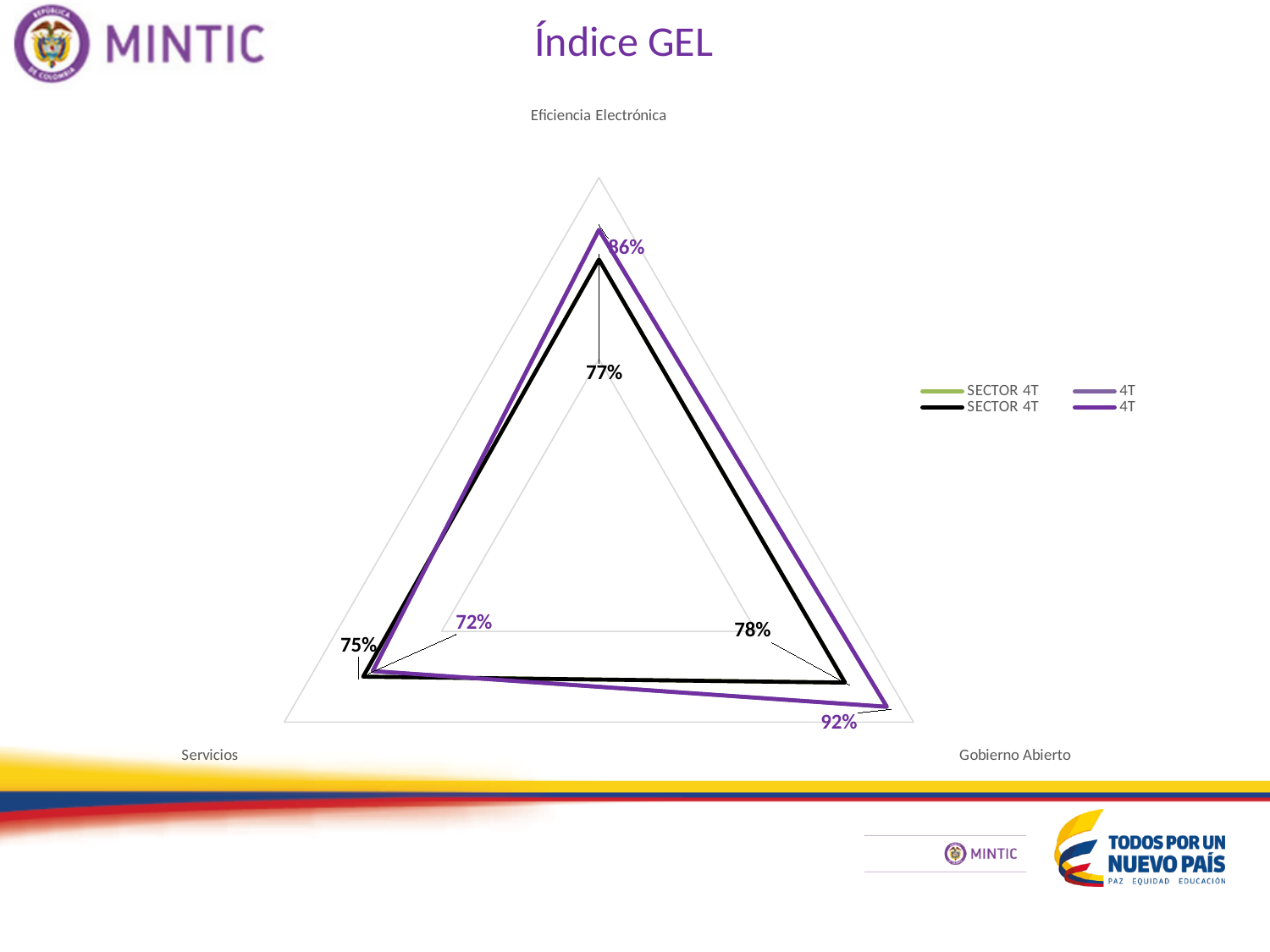
What is the value for Servicios in the 4T series? 72% What is the value for Eficiencia Electrónica in the 4T series? 86% What is the value for Servicios in the SECTOR 4T series? 75% How many categories (axes) does the chart have? 3 What is the value for Gobierno Abierto in the 4T series? 92% What is the value for Eficiencia Electrónica in the SECTOR 4T series? 77% Which category has the highest value in the 4T series? Gobierno Abierto For Servicios, which series has the larger value, SECTOR 4T or 4T? SECTOR 4T What kind of chart is shown on the slide? Radar chart Which category has the lowest value in the 4T series? Servicios What is the value for Gobierno Abierto in the SECTOR 4T series? 78% What is the difference between the 4T and SECTOR 4T values for Gobierno Abierto? 14 percentage points